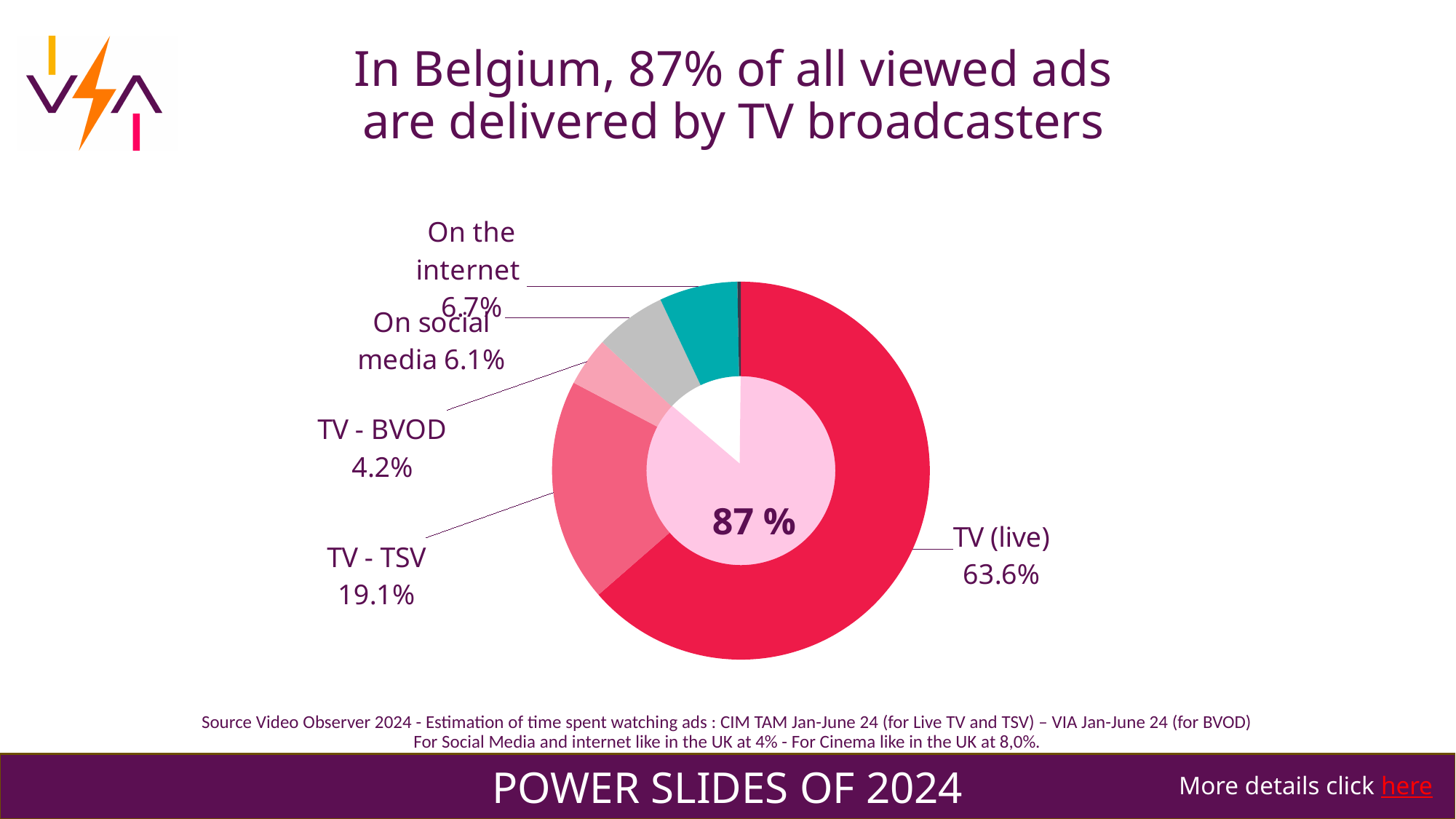
What share of viewed ads is delivered by TV - BVOD? 4.2% What is the difference in share between TV (live) and TV - TSV? 44.5% What share of viewed ads is delivered by TV (live)? 63.6% What kind of chart is shown on the slide? Doughnut (pie) chart How many categories are shown in the chart? 5 Which category has the largest share of viewed ads? TV (live) What share of viewed ads is delivered by TV - TSV? 19.1% What share of viewed ads is viewed on social media? 6.1% What value is printed in the centre of the doughnut chart? 87 % What share of viewed ads is viewed on the internet? 6.7% Which has a larger share, On the internet or On social media? On the internet